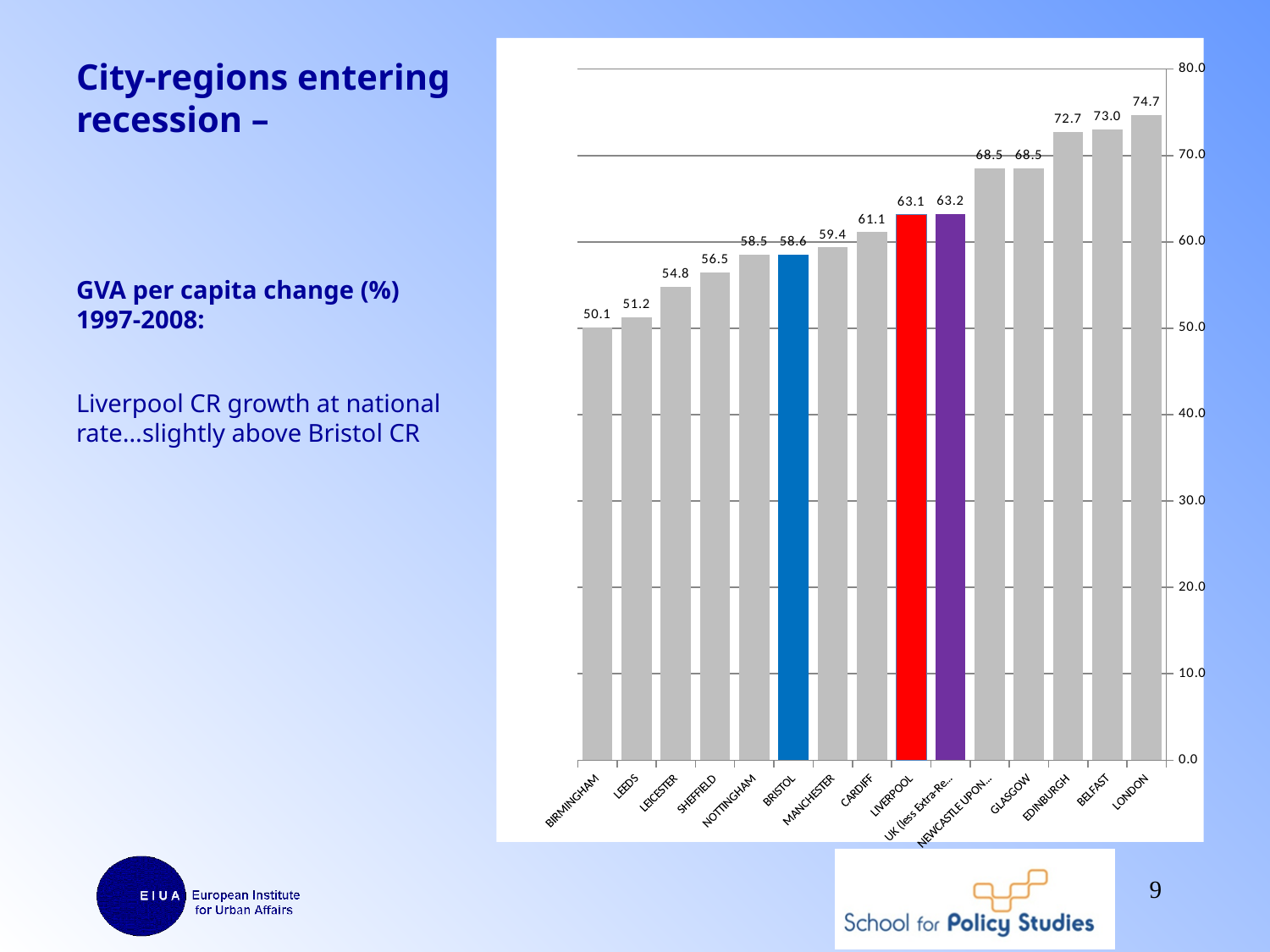
What is the difference between the values for Liverpool and Bristol? 4.5 What type of chart is shown on the slide? Bar chart What is the value shown for London? 74.7 Which has a larger value, Edinburgh or Cardiff? Edinburgh What colour is the bar for Liverpool? Red Which city-region has the highest value in the chart? London How many bars are plotted in the chart? 15 What is the GVA per capita change value for Liverpool? 63.1 Which city-region has the lowest value in the chart? Birmingham What is the difference between the values for London and Birmingham? 24.6 What is the value shown for Bristol? 58.6 What is the value shown for Birmingham? 50.1